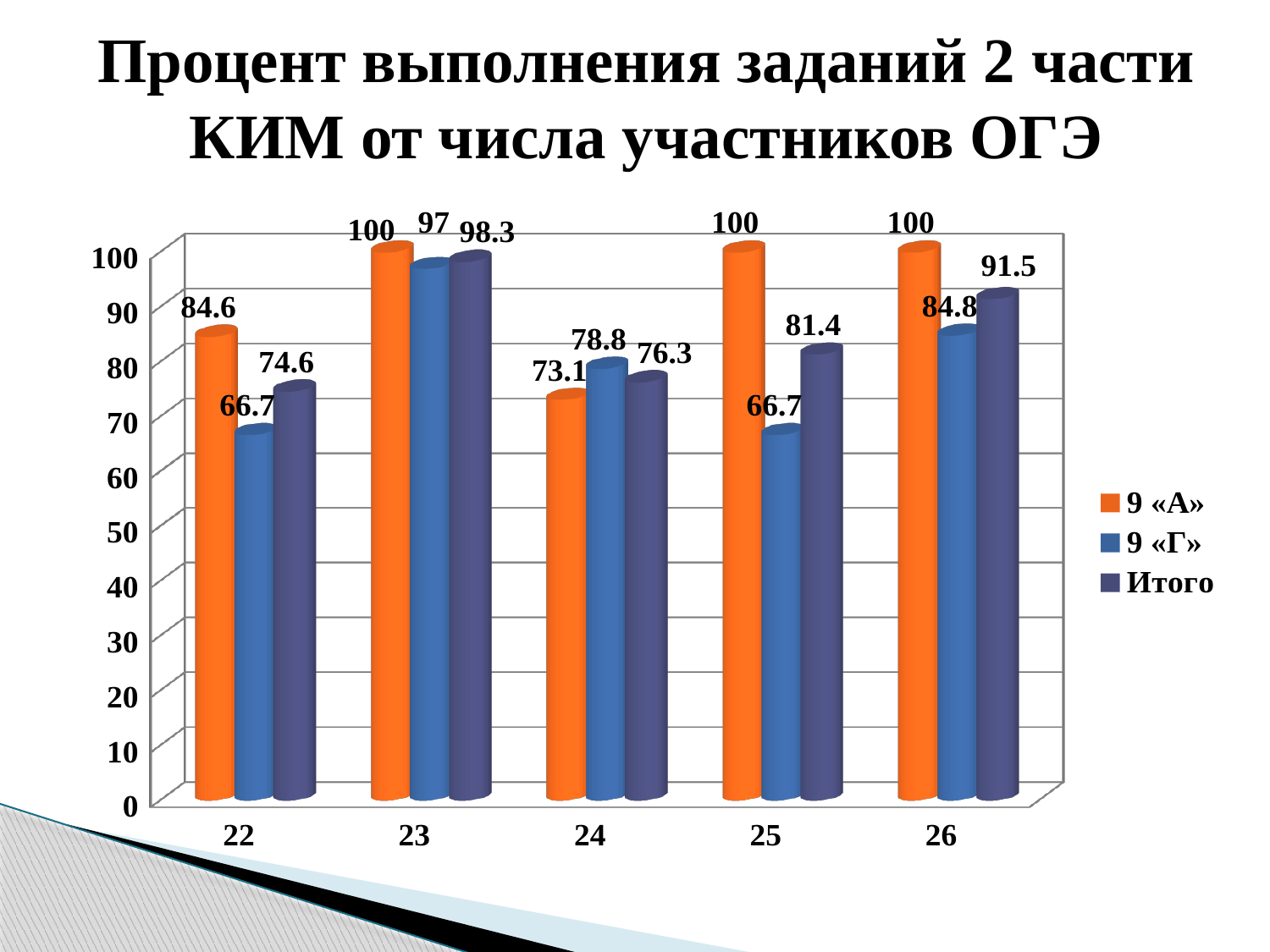
Which series is shown in orange in the legend? 9 «А» What is the value for Итого at category 26? 91.5 What is the value for 9 «Г» at category 25? 66.7 How many series does the legend list? 3 Which category has the lowest value for 9 «А»? 24 How many categories are shown on the x axis? 5 What is the value for 9 «Г» at category 23? 97 What is the difference between the 9 «А» and 9 «Г» values at category 25? 33.3 Which category has the highest value for Итого? 23 Which is larger at category 24: the value for 9 «А» or for 9 «Г»? 9 «Г» What is the value for 9 «А» at category 22? 84.6 What kind of chart is shown on the slide? bar chart